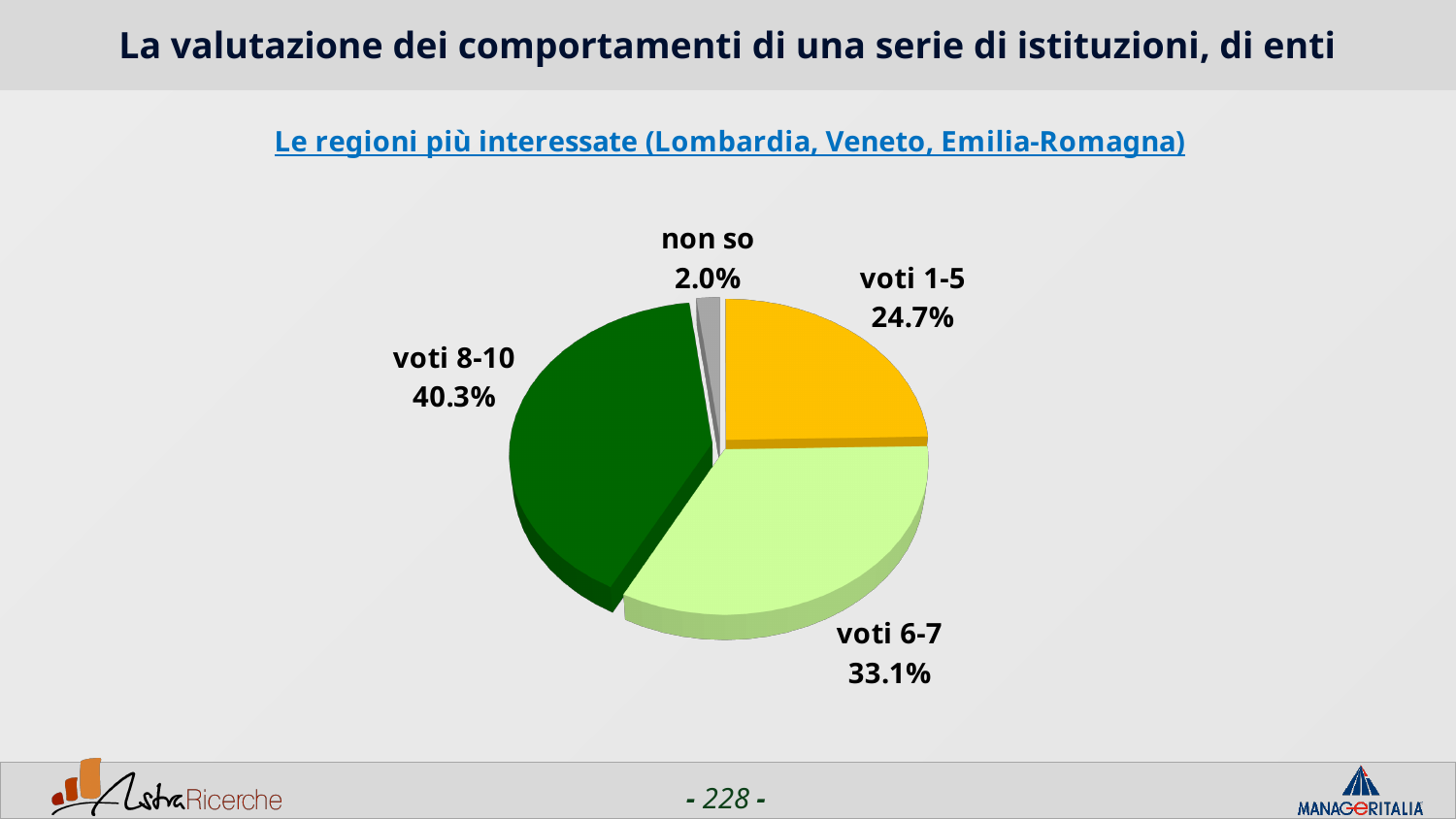
What share of the pie is labelled "non so"? 2.0% What share of the pie is labelled "voti 1-5"? 24.7% Which is larger, the share for "voti 1-5" or the share for "voti 6-7"? voti 6-7 What colour is the "voti 8-10" slice? dark green What share of the pie is labelled "voti 6-7"? 33.1% What share of the pie is labelled "voti 8-10"? 40.3% What is the difference in percentage points between "voti 8-10" and "voti 6-7"? 7.2 What is the combined share of "voti 1-5" and "voti 6-7"? 57.8% Which slice of the pie is the largest? voti 8-10 What kind of chart is shown on the slide? pie chart Which slice of the pie is the smallest? non so How many slices does the pie chart have? 4